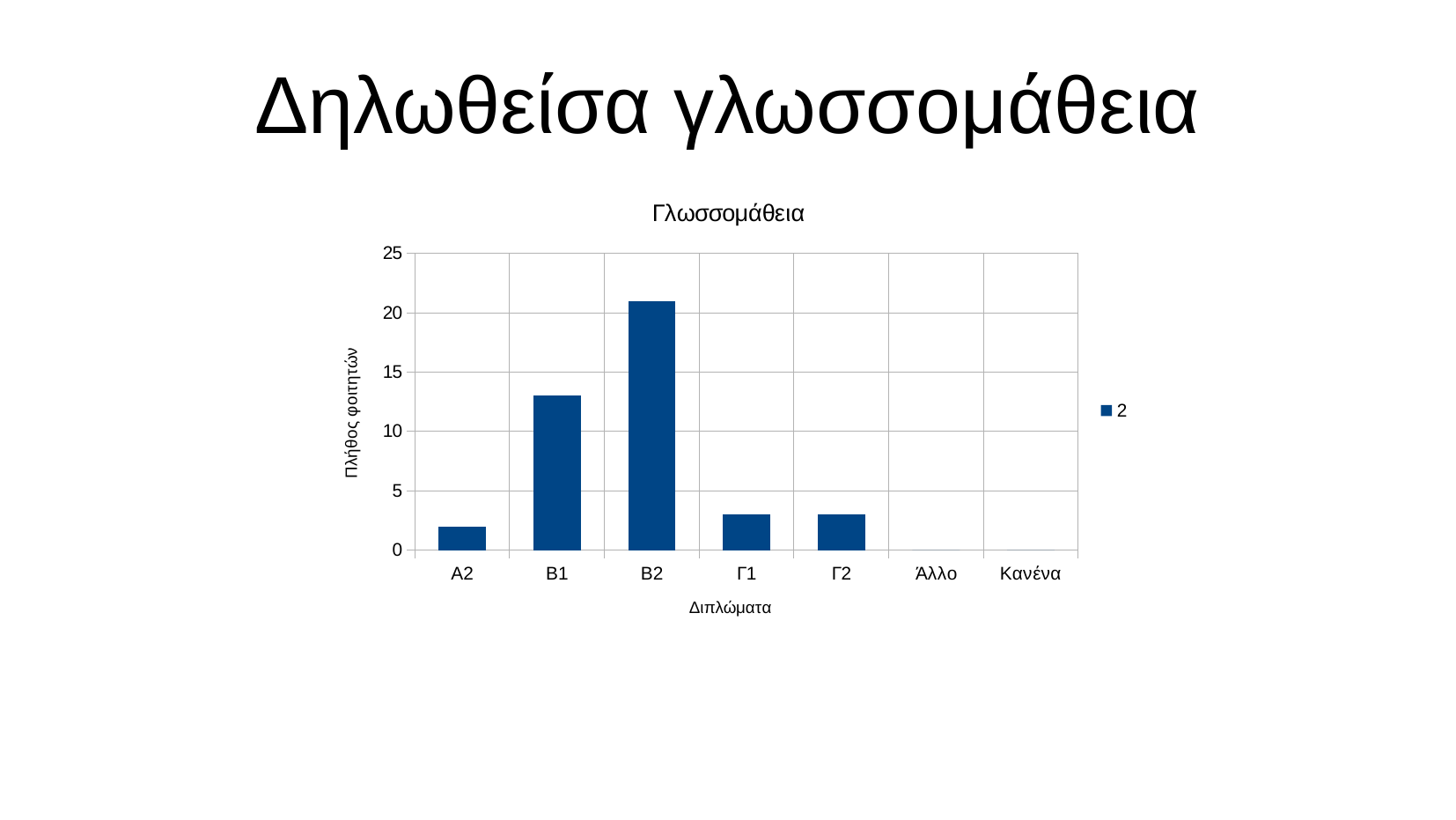
What is the label of the x axis of the chart? Διπλώματα What type of chart is shown on the slide? bar chart Which is larger, the value for B1 or the value for B2? B2 Is the value for B2 greater or less than 20? greater How many series does the legend list? 1 Which category has the highest value in the chart? B2 How many categories are shown on the x axis of the chart? 7 Is the value for B1 greater or less than 15? less Is the value for A2 greater or less than 5? less What is the title of the chart? Γλωσσομάθεια What is the value for Άλλο in the chart? 0 Which is larger, the value for A2 or the value for B1? B1